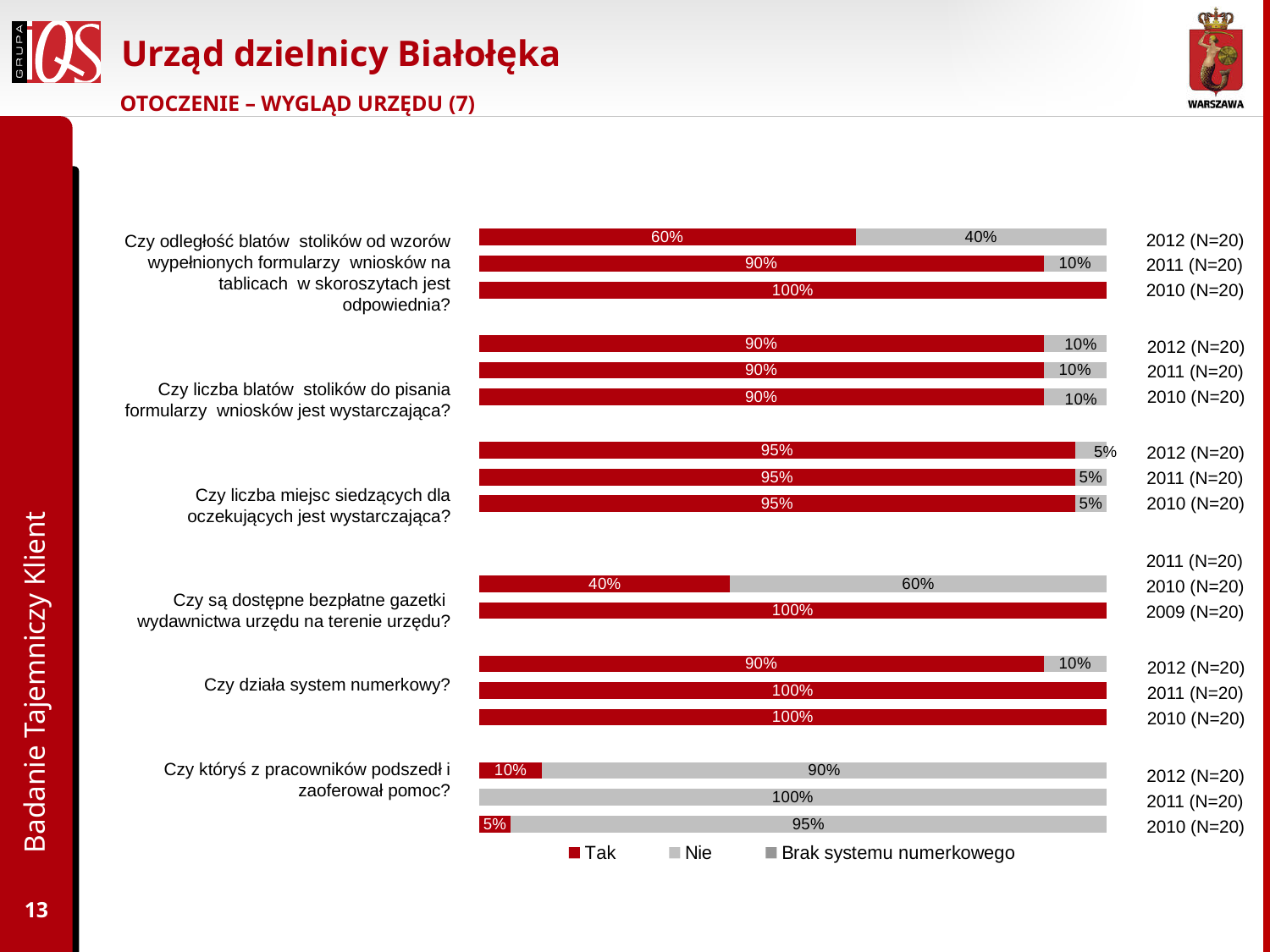
What kind of chart is shown on the slide? Stacked bar chart For the question "Czy liczba blatów stolików do pisania formularzy wniosków jest wystarczająca?", what is the "Tak" value in 2010 (N=20)? 90% For the question "Czy odległość blatów stolików od wzorów wypełnionych formularzy wniosków na tablicach w skoroszytach jest odpowiednia?", what is the "Nie" value in 2011 (N=20)? 10% For the question "Czy odległość blatów stolików od wzorów wypełnionych formularzy wniosków na tablicach w skoroszytach jest odpowiednia?", what is the difference between the "Tak" values in 2011 (N=20) and 2012 (N=20)? 30% How many series does the legend list? 3 For the question "Czy któryś z pracowników podszedł i zaoferował pomoc?", what is the "Tak" value in 2012 (N=20)? 10% What are the legend entries of the chart? Tak, Nie, Brak systemu numerkowego For the question "Czy któryś z pracowników podszedł i zaoferował pomoc?", which is larger: the "Tak" value in 2012 (N=20) or in 2010 (N=20)? 2012 (N=20) For the question "Czy odległość blatów stolików od wzorów wypełnionych formularzy wniosków na tablicach w skoroszytach jest odpowiednia?", which year has the lowest "Tak" value? 2012 (N=20) For the question "Czy działa system numerkowy?", what is the "Tak" value in 2011 (N=20)? 100% For the question "Czy liczba miejsc siedzących dla oczekujących jest wystarczająca?", what is the "Nie" value in 2012 (N=20)? 5% For the question "Czy odległość blatów stolików od wzorów wypełnionych formularzy wniosków na tablicach w skoroszytach jest odpowiednia?", what is the "Tak" value in 2012 (N=20)? 60%